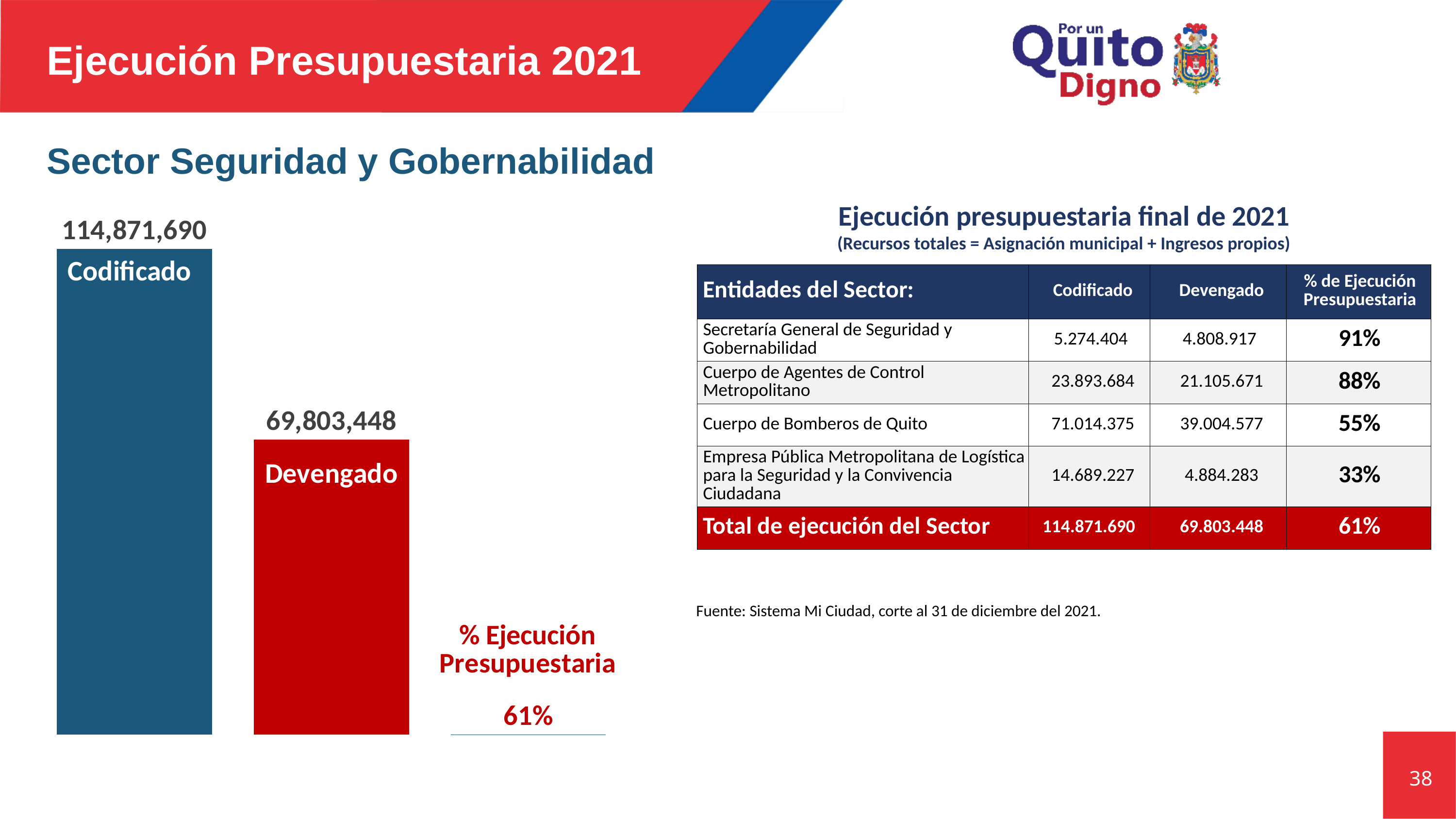
What type of chart is shown on the left of the slide? Bar chart Which is larger in the bar chart, Codificado or Devengado? Codificado Which bar in the chart is the tallest? Codificado What is the value of the Codificado bar in the bar chart? 114,871,690 How many bars are plotted in the bar chart? 2 What % Ejecución Presupuestaria is shown next to the bars in the chart? 61% What colour is the Codificado bar in the chart? Blue Which bar in the chart is the shortest? Devengado Do the values fall or rise from the Codificado bar to the Devengado bar? Fall What is the difference between the Codificado and Devengado values in the bar chart? 45,068,242 What is the value of the Devengado bar in the bar chart? 69,803,448